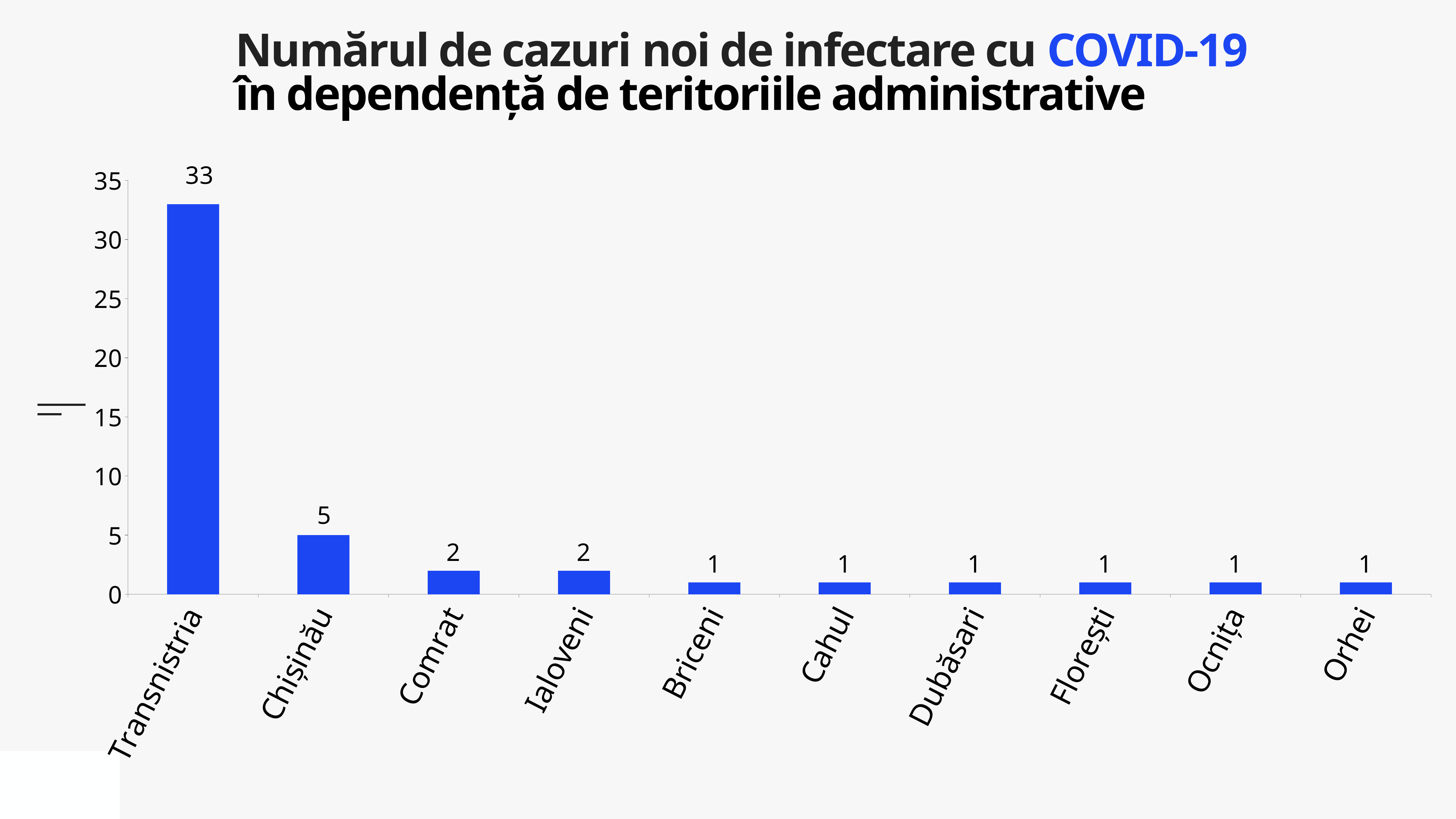
Do the values rise or fall from left to right along the x axis? fall Is the value for Transnistria greater or less than 30? greater What is the value for Chișinău? 5 What is the value for Cahul? 1 Which is larger, the value for Chișinău or the value for Comrat? Chișinău What is the value for Transnistria? 33 What is the difference between the values for Chișinău and Ialoveni? 3 What kind of chart is shown on the slide? bar chart What is the difference between the values for Transnistria and Chișinău? 28 What is the value for Comrat? 2 Which category has the highest value? Transnistria How many categories are shown on the x axis? 10